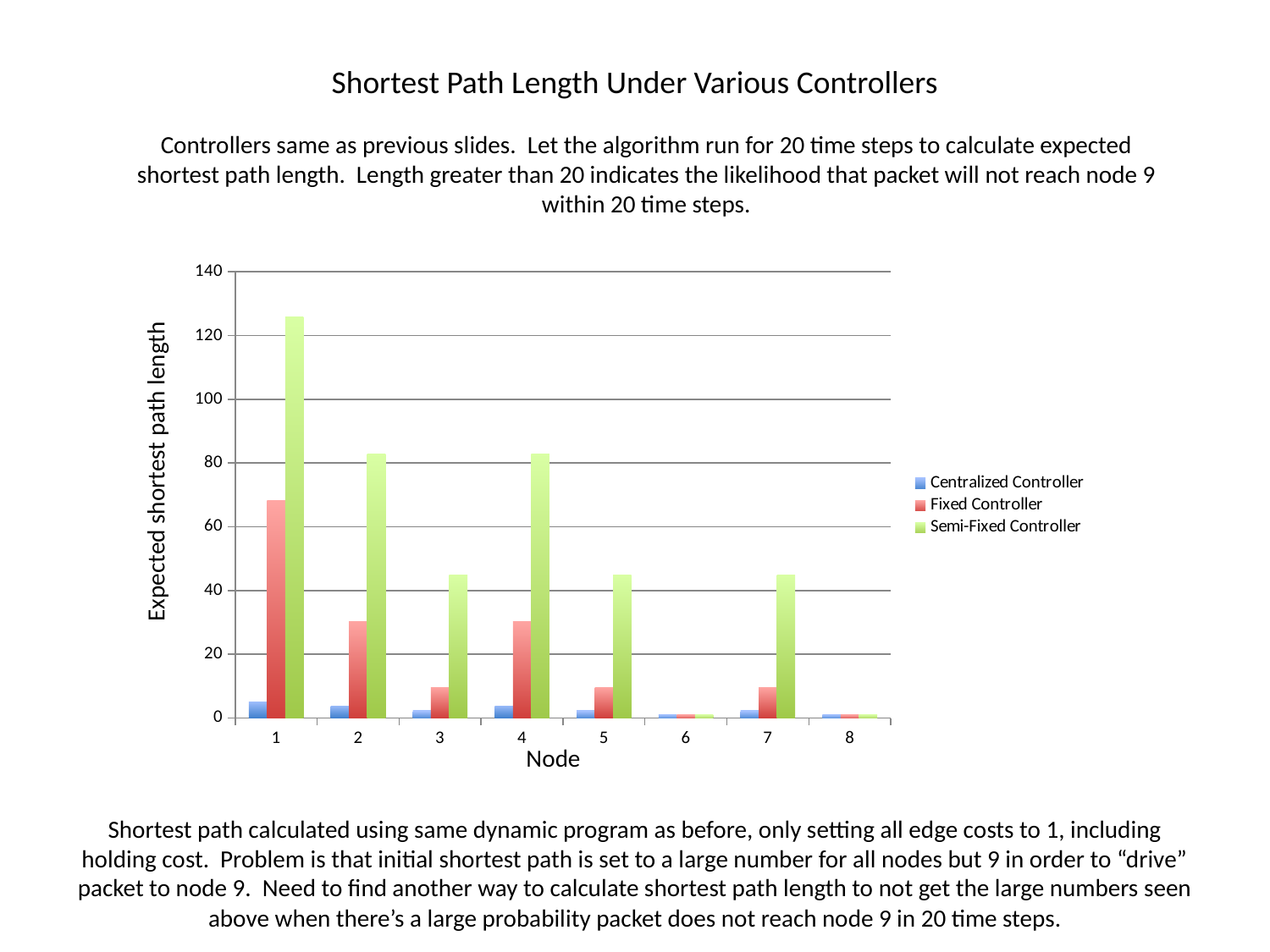
Is the Fixed Controller value for node 2 greater or less than 40? less Which node has the highest value for the Semi-Fixed Controller? 1 Is the Semi-Fixed Controller value for node 2 greater or less than 100? less What is the title of the y axis? Expected shortest path length How many series does the legend list? 3 How many nodes are shown along the x axis? 8 Which series has the highest value at node 1? Semi-Fixed Controller At node 4, which is larger: the Fixed Controller value or the Semi-Fixed Controller value? Semi-Fixed Controller At node 1, which is larger: the Centralized Controller value or the Fixed Controller value? Fixed Controller Is the Semi-Fixed Controller value for node 1 greater or less than 120? greater What kind of chart is shown on the slide? bar chart